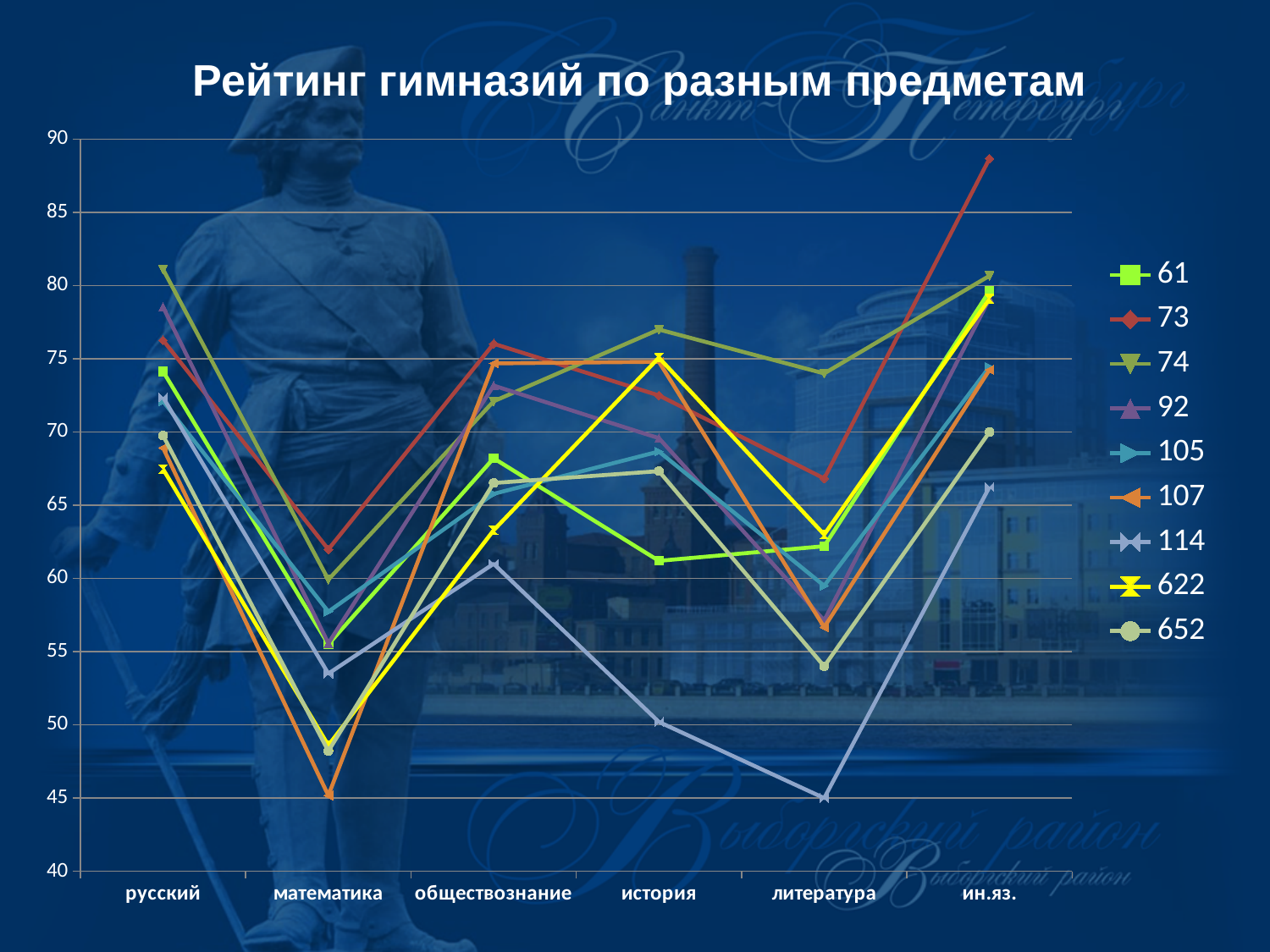
What kind of chart is shown on the slide? line chart Is the value for series 107 at математика greater or less than 50? less Is the value for series 114 at литература greater or less than 50? less What is the title of the chart? Рейтинг гимназий по разным предметам Which series has the lowest value at литература? 114 Does the value for series 73 rise or fall from литература to ин.яз.? rise Is the value for series 74 at русский greater or less than 80? greater How many subject categories are shown on the x axis? 6 At история, which series has the larger value, 74 or 61? 74 Which series has the highest value at ин.яз.? 73 How many series does the legend list? 9